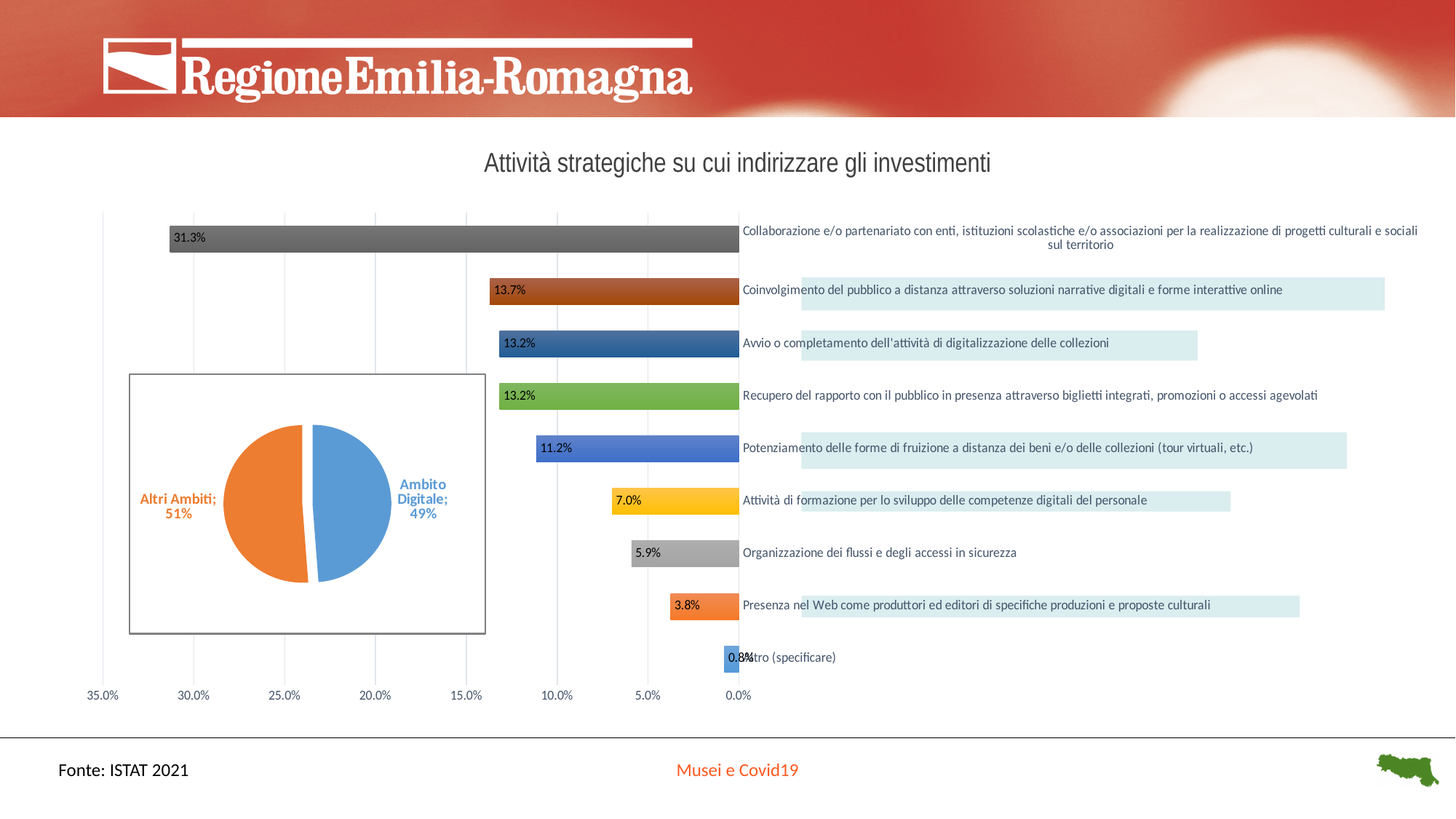
How many categories does the bar chart show? 9 In the bar chart, what is the difference between the value for 'Coinvolgimento del pubblico a distanza attraverso soluzioni narrative digitali e forme interattive online' and the value for 'Presenza nel Web come produttori ed editori di specifiche produzioni e proposte culturali'? 9.9% What kind of chart is the main chart titled 'Attività strategiche su cui indirizzare gli investimenti'? bar chart In the bar chart, what is the value for 'Organizzazione dei flussi e degli accessi in sicurezza'? 5.9% In the bar chart, which is larger: the value for 'Coinvolgimento del pubblico a distanza attraverso soluzioni narrative digitali e forme interattive online' or the value for 'Attività di formazione per lo sviluppo delle competenze digitali del personale'? Coinvolgimento del pubblico a distanza attraverso soluzioni narrative digitali e forme interattive online In the bar chart, what is the value for 'Potenziamento delle forme di fruizione a distanza dei beni e/o delle collezioni (tour virtuali, etc.)'? 11.2% In the pie chart, what share does 'Ambito Digitale' have? 49% In the bar chart, which category has the highest value? Collaborazione e/o partenariato con enti, istituzioni scolastiche e/o associazioni per la realizzazione di progetti culturali e sociali sul territorio In the bar chart, is the value for 'Collaborazione e/o partenariato con enti, istituzioni scolastiche e/o associazioni per la realizzazione di progetti culturali e sociali sul territorio' greater or less than 30.0%? greater In the bar chart, which category has the lowest value? Altro (specificare) In the bar chart, what is the value for 'Attività di formazione per lo sviluppo delle competenze digitali del personale'? 7.0% In the pie chart, which slice is larger: 'Altri Ambiti' or 'Ambito Digitale'? Altri Ambiti